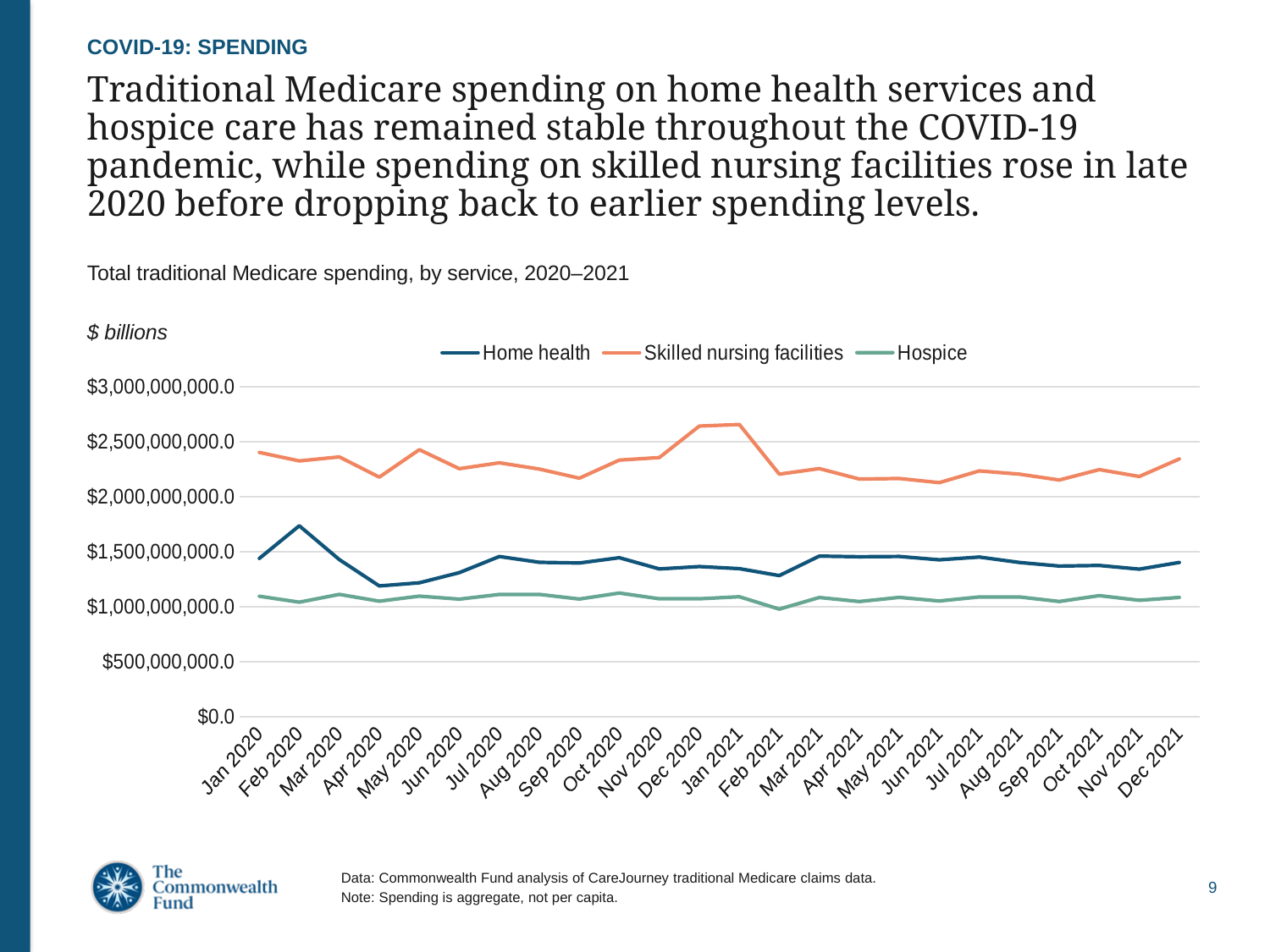
Which is larger in Dec 2021, Home health spending or Hospice spending? Home health In which month does the Home health series reach its highest value? Feb 2020 How many monthly data points are plotted along the x axis? 24 Which series has the highest spending in every month shown? Skilled nursing facilities How many series does the legend list? 3 Is the value for Home health in Apr 2020 greater or less than $1,500,000,000.0? less Is the value for Skilled nursing facilities in Jan 2021 greater or less than $2,500,000,000.0? greater What kind of chart is shown on the slide? line chart In which month does the Hospice series reach its lowest value? Feb 2021 What unit is shown on the y axis label above the chart? $ billions Does the Skilled nursing facilities series rise or fall from Jan 2021 to Feb 2021? fall Is the value for Skilled nursing facilities in Apr 2020 greater or less than $2,500,000,000.0? less